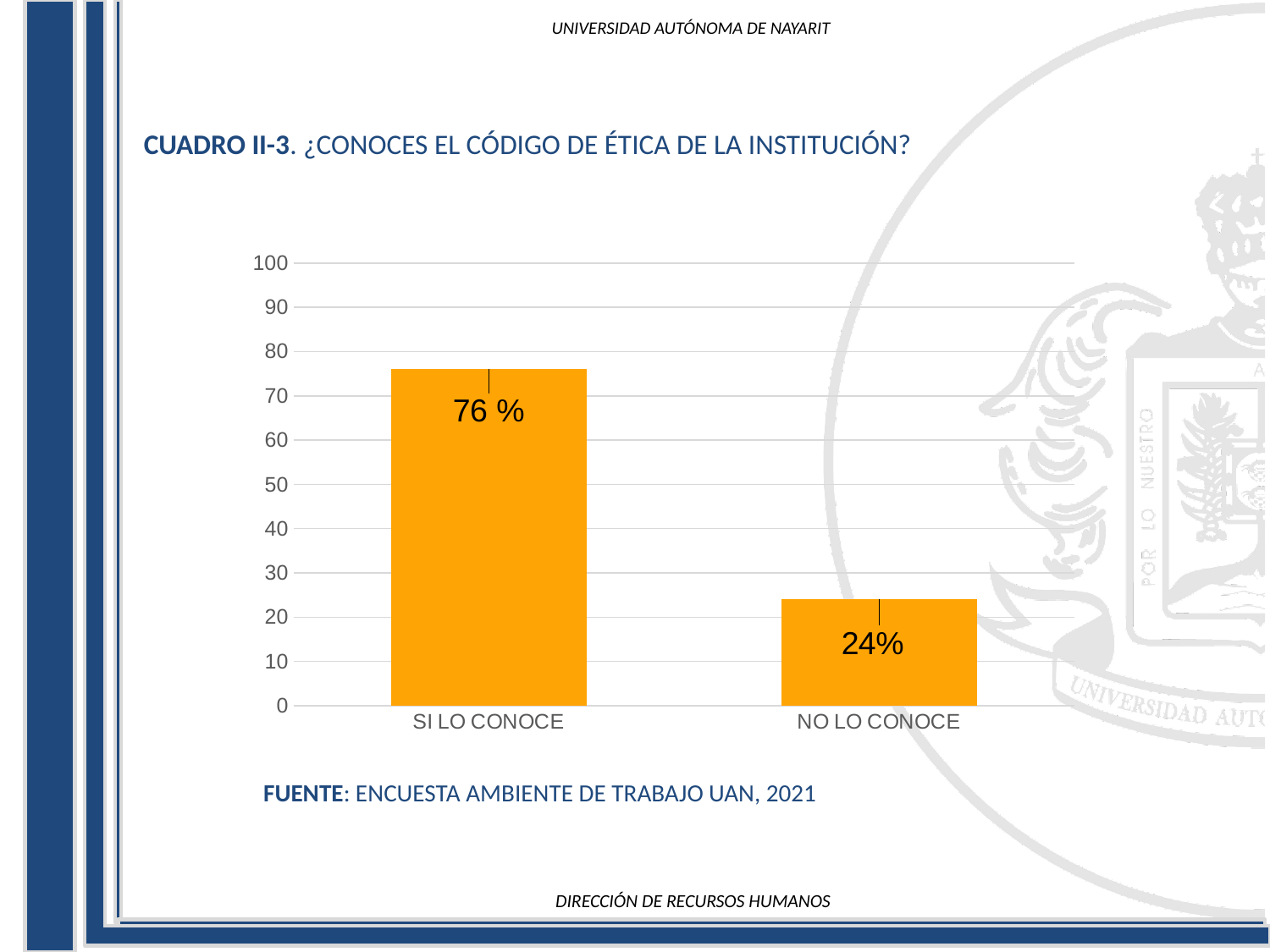
Is the value for NO LO CONOCE greater or less than 30? less Which is larger, the value for SI LO CONOCE or the value for NO LO CONOCE? SI LO CONOCE Which category has the lowest value? NO LO CONOCE What is the title of the chart? CUADRO II-3. ¿CONOCES EL CÓDIGO DE ÉTICA DE LA INSTITUCIÓN? What is the source cited below the chart? ENCUESTA AMBIENTE DE TRABAJO UAN, 2021 What is the value for SI LO CONOCE? 76 % How many categories are shown on the x axis? 2 Is the value for SI LO CONOCE greater or less than 70? greater Which category has the highest value? SI LO CONOCE What is the difference between the values for SI LO CONOCE and NO LO CONOCE? 52% What kind of chart is shown on the slide? bar chart What is the value for NO LO CONOCE? 24%